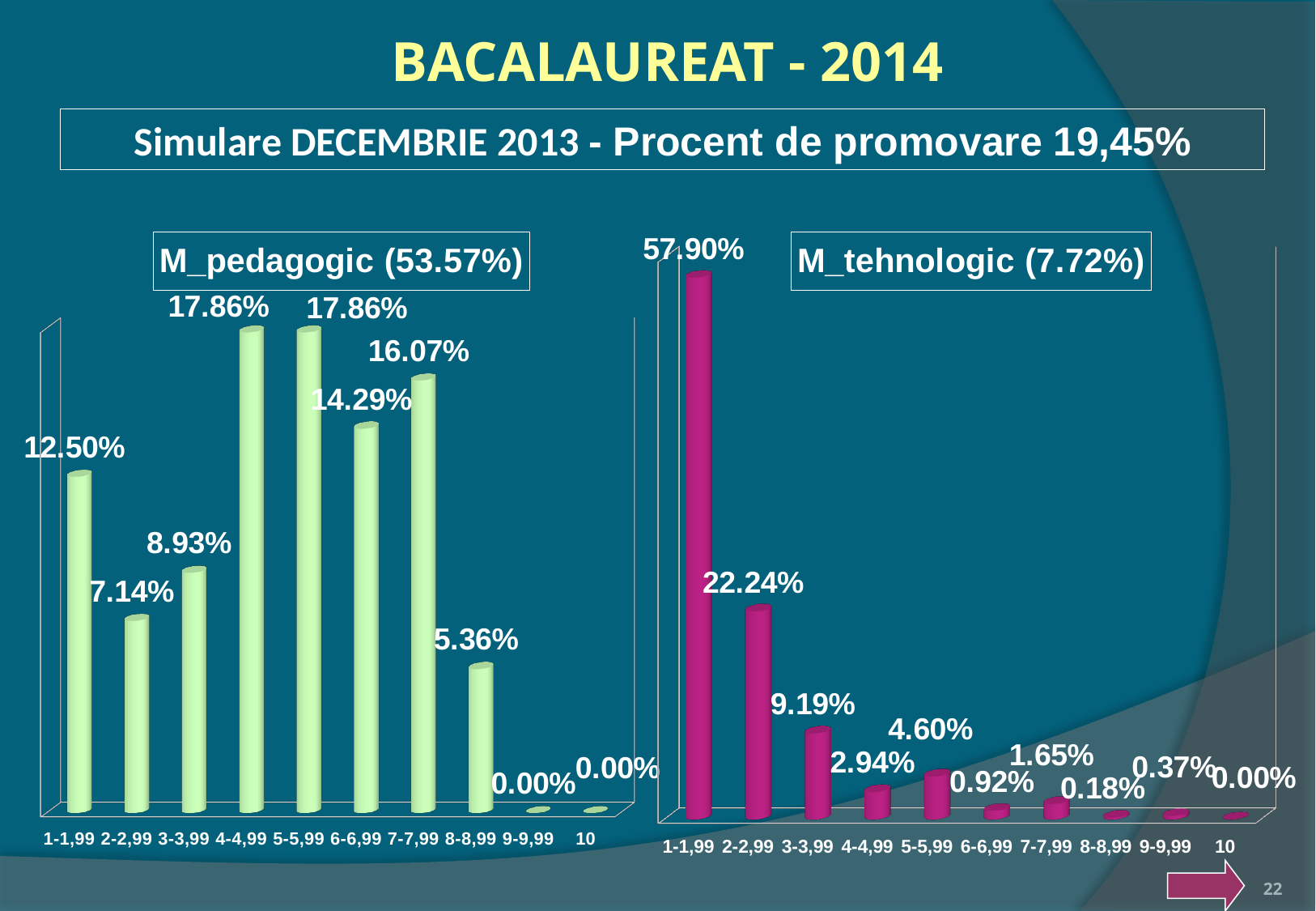
In the M_pedagogic chart, what is the value for the 1-1,99 category? 12.50% How many categories are shown on the x axis of the M_tehnologic chart? 10 What overall pass rate (procent de promovare) is stated in the subtitle of the slide? 19,45% In the M_tehnologic chart, do the values generally rise or fall from 1-1,99 to 10? fall In the M_tehnologic chart, which is larger, the value for 4-4,99 or the value for 5-5,99? 5-5,99 In the M_tehnologic chart, what is the value for the 2-2,99 category? 22.24% In the M_tehnologic chart, what is the value for the 5-5,99 category? 4.60% In the M_tehnologic chart, which category has the highest value? 1-1,99 In the M_pedagogic chart, what is the difference between the values for 7-7,99 and 8-8,99? 10.71% In the M_pedagogic chart, which is larger, the value for 2-2,99 or the value for 3-3,99? 3-3,99 What kind of chart is the M_pedagogic chart? bar chart In the M_pedagogic chart, what is the value for the 8-8,99 category? 5.36%